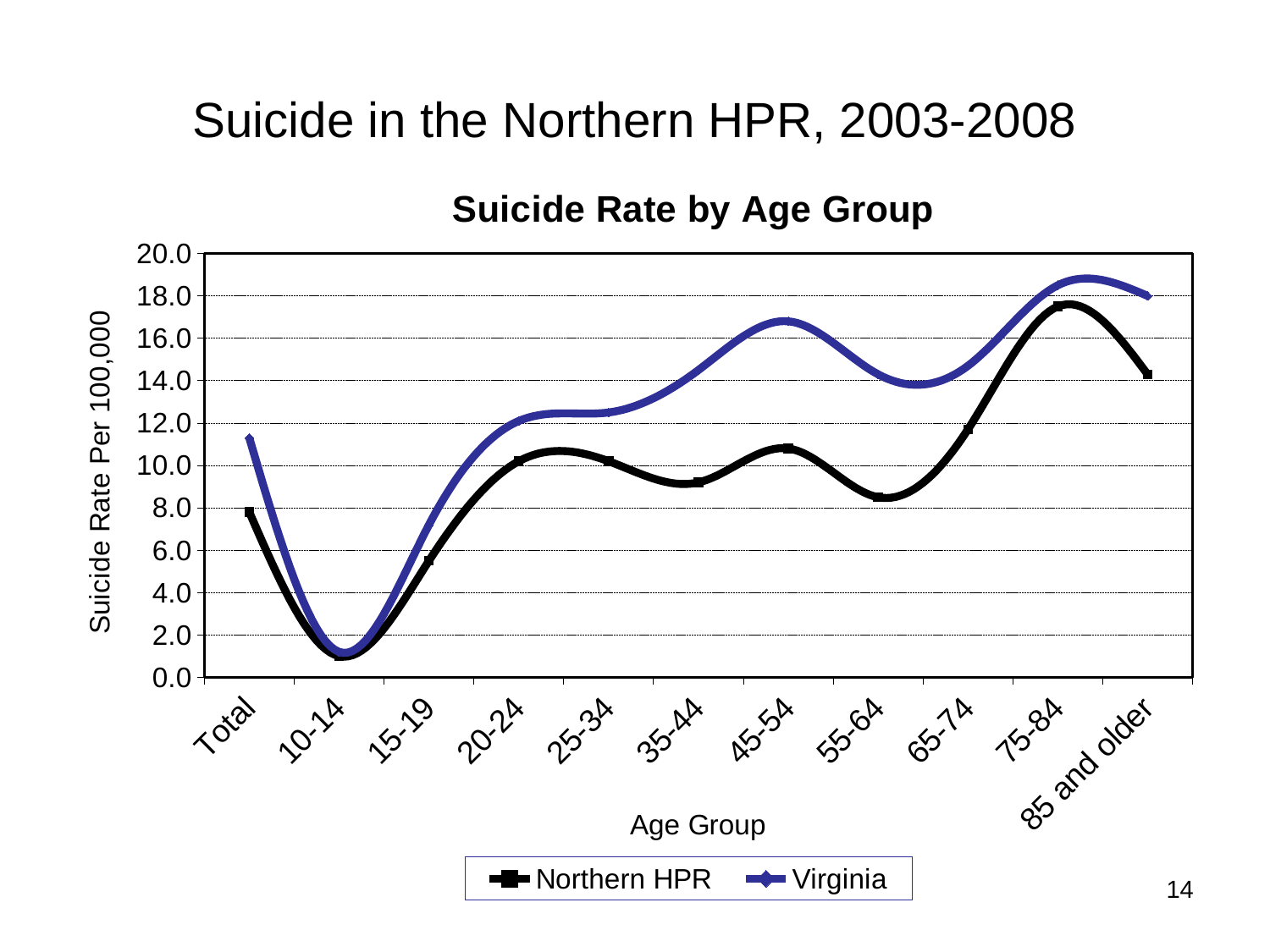
Is the Northern HPR value for the 75-84 age group greater or less than 16.0? greater What is the title of the chart? Suicide Rate by Age Group Which age group has the highest suicide rate for Northern HPR? 75-84 Is the Virginia value for the 45-54 age group greater or less than 16.0? greater How many age group categories are shown on the x axis? 11 What kind of chart is shown on the slide? line chart Is the Northern HPR value for the Total category greater or less than 10.0? less For the 45-54 age group, which series has the larger value, Northern HPR or Virginia? Virginia Does the Northern HPR line rise or fall from the 55-64 age group to the 75-84 age group? rise How many series does the legend list? 2 Which age group has the lowest suicide rate for Virginia? 10-14 Which age group has the lowest suicide rate for Northern HPR? 10-14